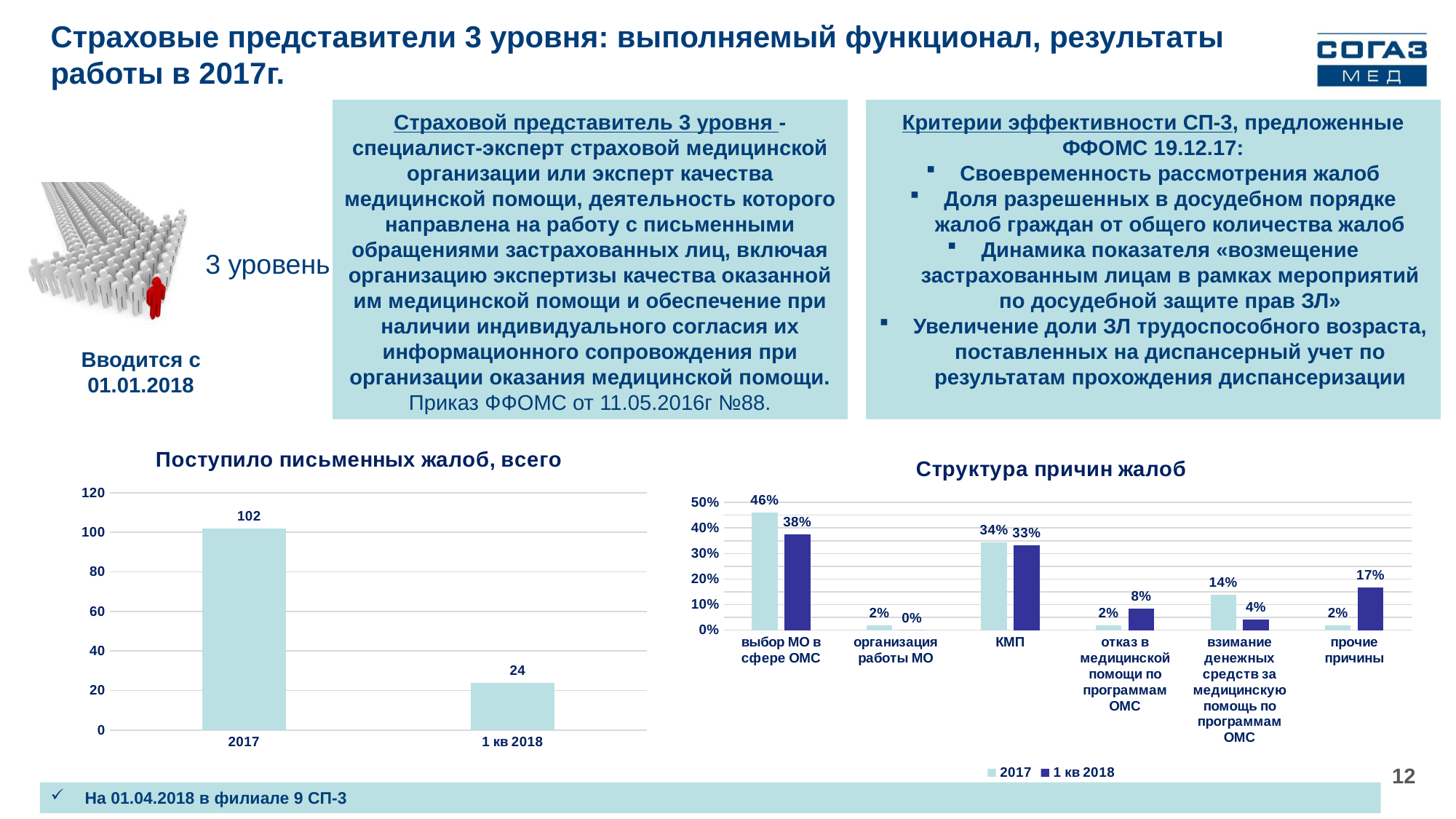
In the chart 'Поступило письменных жалоб, всего', what is the value for 2017? 102 In the chart 'Структура причин жалоб', what is the 1 кв 2018 value for 'организация работы МО'? 0% In the chart 'Структура причин жалоб', what is the 1 кв 2018 value for 'прочие причины'? 17% What kind of chart is 'Поступило письменных жалоб, всего'? bar chart In the chart 'Структура причин жалоб', which is larger for 'взимание денежных средств за медицинскую помощь по программам ОМС': the 2017 value or the 1 кв 2018 value? 2017 In the chart 'Структура причин жалоб', what is the 2017 value for 'выбор МО в сфере ОМС'? 46% How many series does the legend of the chart 'Структура причин жалоб' list? 2 In the chart 'Поступило письменных жалоб, всего', what is the difference between the 2017 value and the 1 кв 2018 value? 78 In the chart 'Поступило письменных жалоб, всего', what is the value for 1 кв 2018? 24 How many categories are shown on the x axis of the chart 'Структура причин жалоб'? 6 In the chart 'Структура причин жалоб', which category has the lowest 1 кв 2018 value? организация работы МО In the chart 'Структура причин жалоб', which category has the highest 2017 value? выбор МО в сфере ОМС